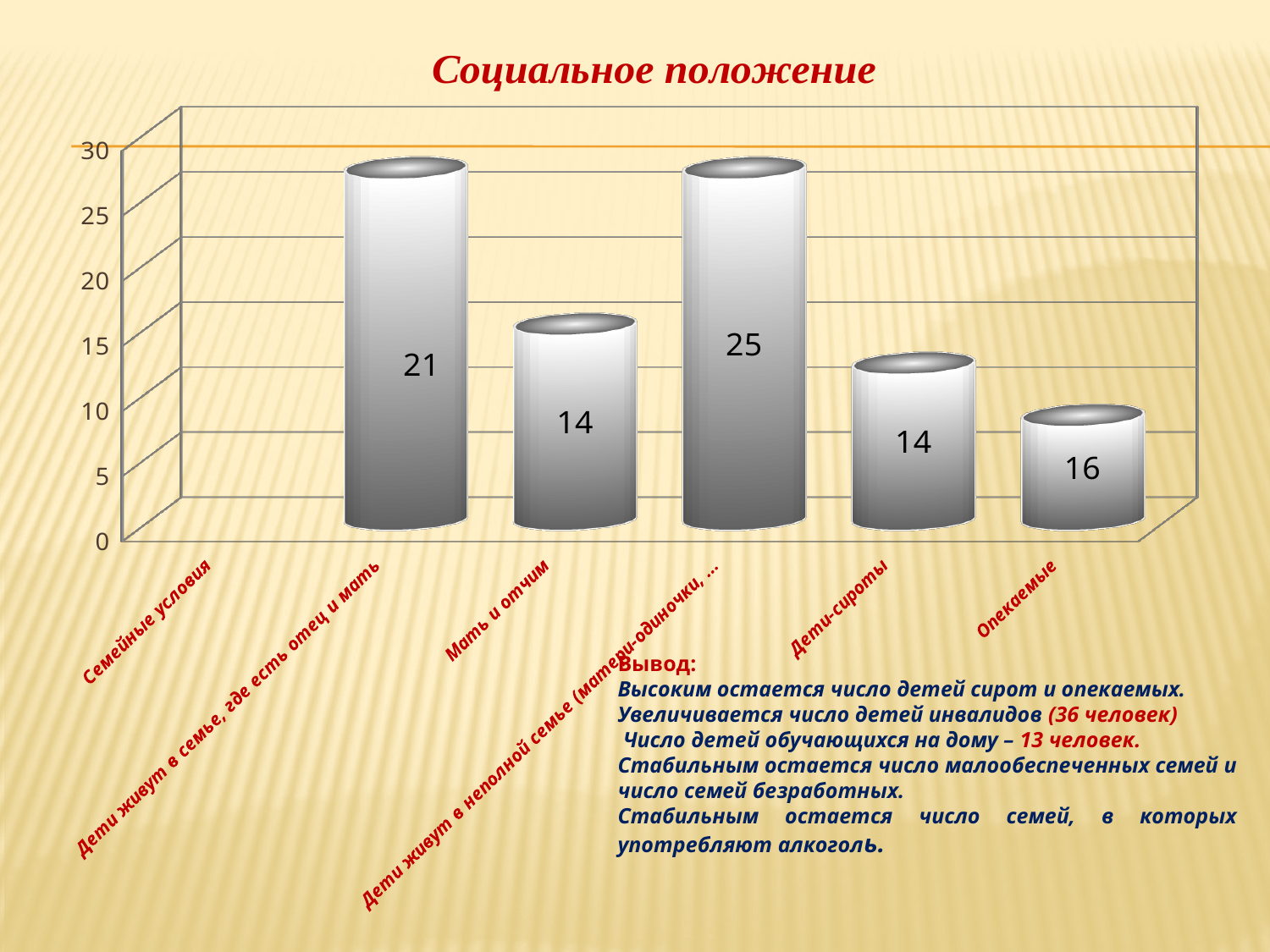
What kind of chart is shown on the slide? Bar chart What is the value for 'Дети-сироты'? 14 What is the title of the chart? Социальное положение How many bars are plotted on the chart? 5 Which is larger: the value for 'Дети живут в семье, где есть отец и мать' or the value for 'Мать и отчим'? Дети живут в семье, где есть отец и мать What is the difference between the values for 'Опекаемые' and 'Дети-сироты'? 2 Which category has the highest value according to the data labels? Дети живут в неполной семье (матери-одиночки, ...) What is the value for 'Дети живут в семье, где есть отец и мать'? 21 What is the difference between the values for 'Дети живут в неполной семье (матери-одиночки, ...)' and 'Дети живут в семье, где есть отец и мать'? 4 What is the value for 'Опекаемые'? 16 What is the value for the category 'Мать и отчим'? 14